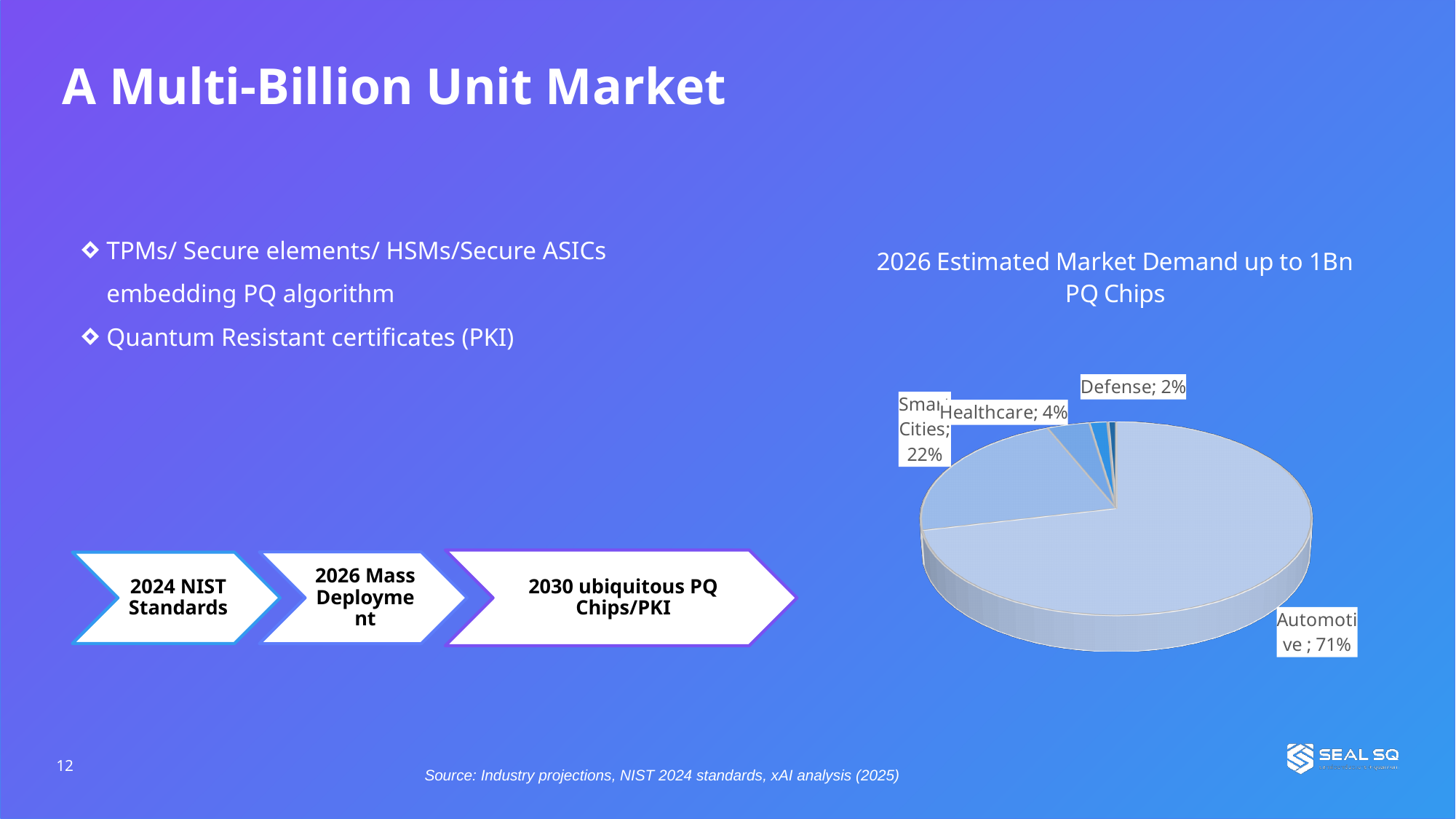
Which slice is larger, Healthcare or Defense? Healthcare What is the difference in percentage points between the Healthcare and Defense slices? 2 Which labelled slice of the pie is the largest? Automotive What is the difference in percentage points between the Automotive and Smart Cities slices? 49 What is the title of the pie chart? 2026 Estimated Market Demand up to 1Bn PQ Chips What share of the pie does Healthcare account for? 4% What kind of chart is shown on the slide? Pie chart Is the Smart Cities share greater or less than 50%? less What share of the pie does Automotive account for? 71% What share of the pie does Defense account for? 2% What share of the pie does Smart Cities account for? 22% Which labelled slice of the pie is the smallest? Defense